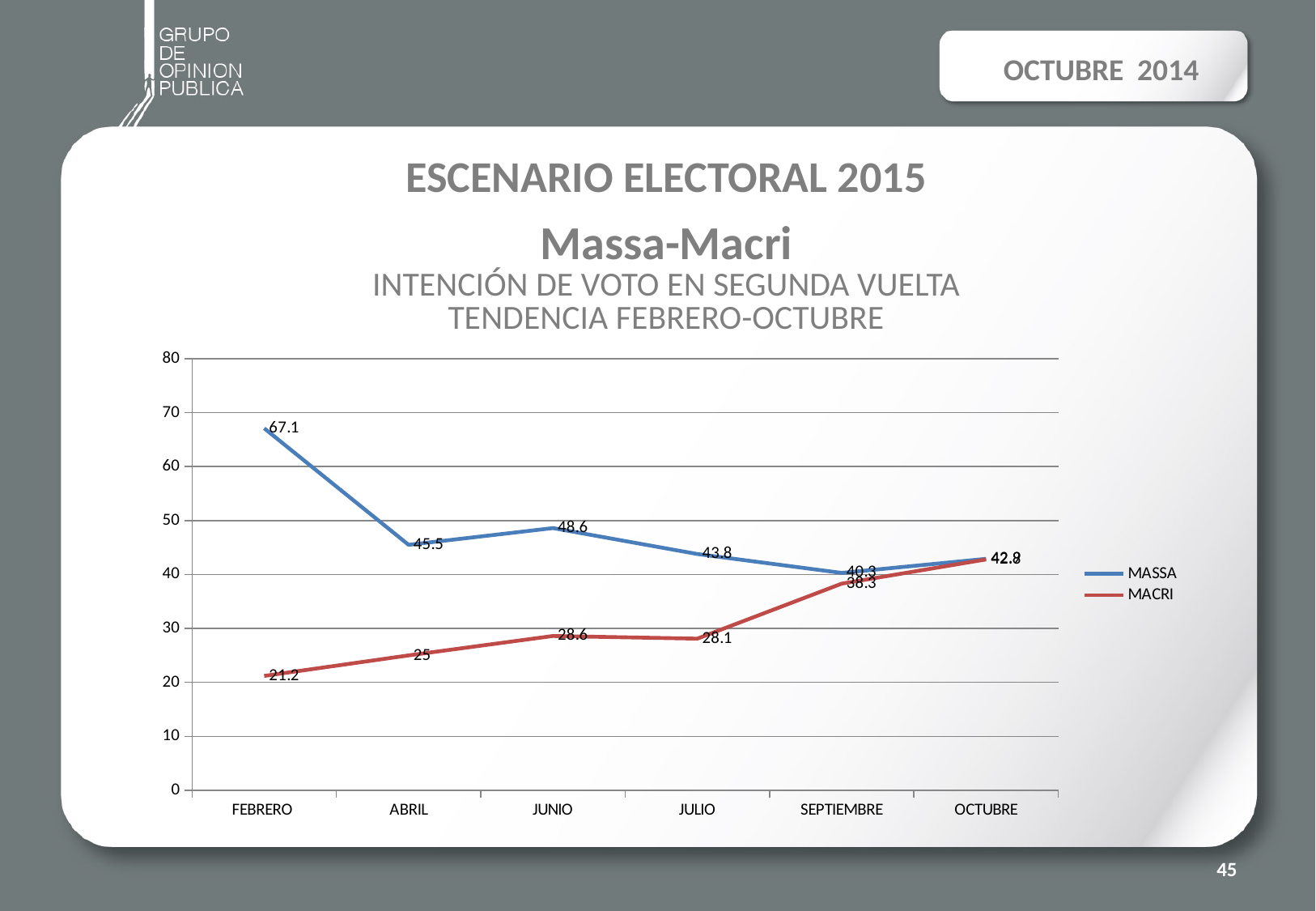
In which month is the MACRI value lowest? FEBRERO What is the value for MACRI in ABRIL? 25 What is the value for MACRI in SEPTIEMBRE? 38.3 Is the value for MACRI in JUNIO greater or less than 30? less What kind of chart is shown on the slide? line chart In which month is the MASSA value highest? FEBRERO How many series does the legend list? 2 In JULIO, which series has the larger value, MASSA or MACRI? MASSA What is the value for MASSA in FEBRERO? 67.1 How many months are shown on the x axis? 6 What is the value for MASSA in JUNIO? 48.6 What is the difference between the MASSA and MACRI values in FEBRERO? 45.9